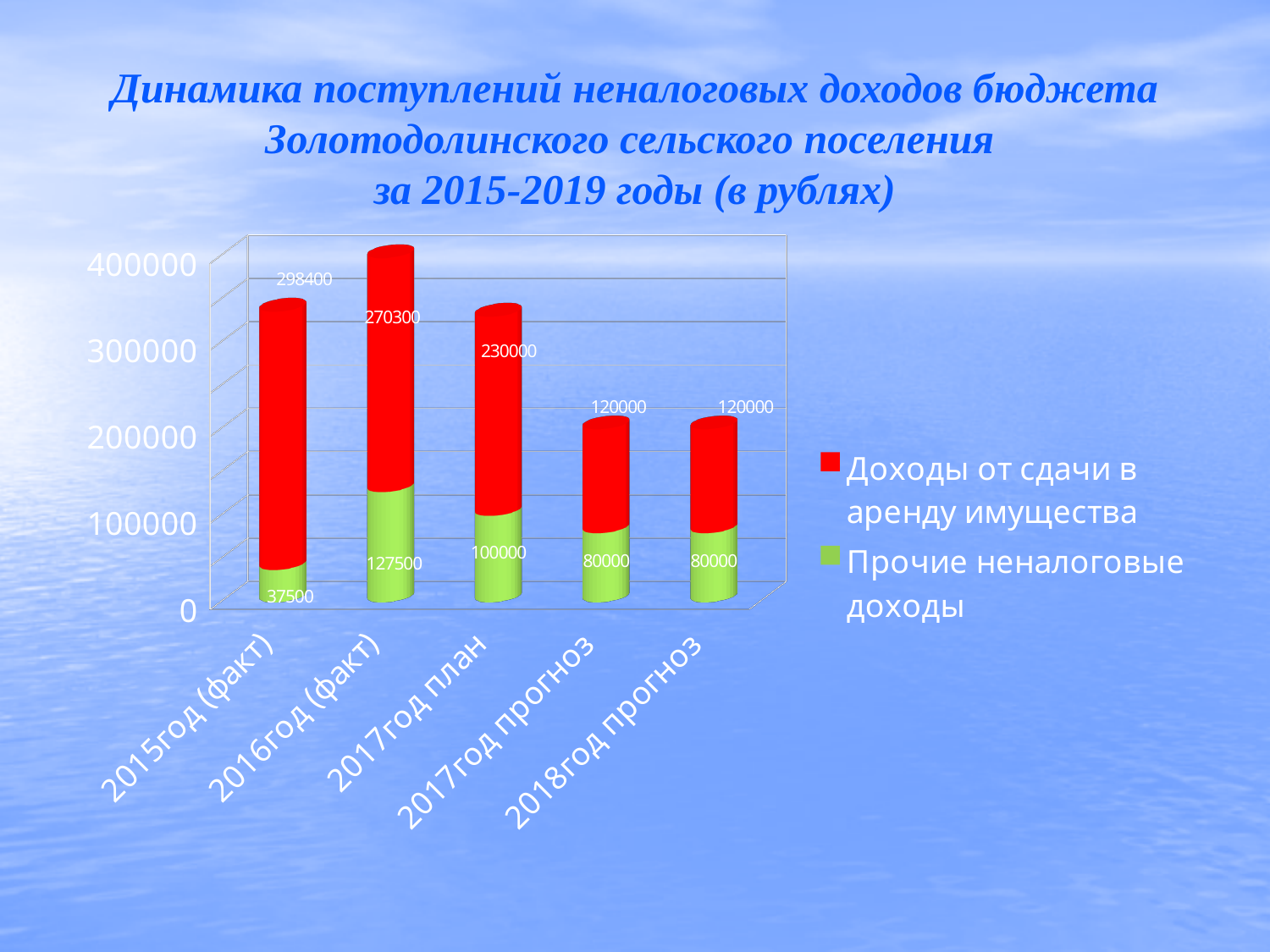
What is the value of 'Доходы от сдачи в аренду имущества' for 2015год (факт)? 298400 What is the difference between 'Доходы от сдачи в аренду имущества' for 2015год (факт) and 2016год (факт)? 28100 What is the value of 'Прочие неналоговые доходы' for 2016год (факт)? 127500 Which category has the highest value for 'Доходы от сдачи в аренду имущества'? 2015год (факт) What is the value of 'Доходы от сдачи в аренду имущества' for 2018год прогноз? 120000 How many categories are shown on the x axis? 5 What is the value of 'Прочие неналоговые доходы' for 2017год план? 100000 What is the total of the stacked bar for 2017год прогноз? 200000 Which category has the lowest value for 'Прочие неналоговые доходы'? 2015год (факт) Which is larger: 'Прочие неналоговые доходы' for 2016год (факт) or for 2017год план? 2016год (факт) What is the total of the stacked bar for 2016год (факт)? 397800 How many series does the legend list? 2